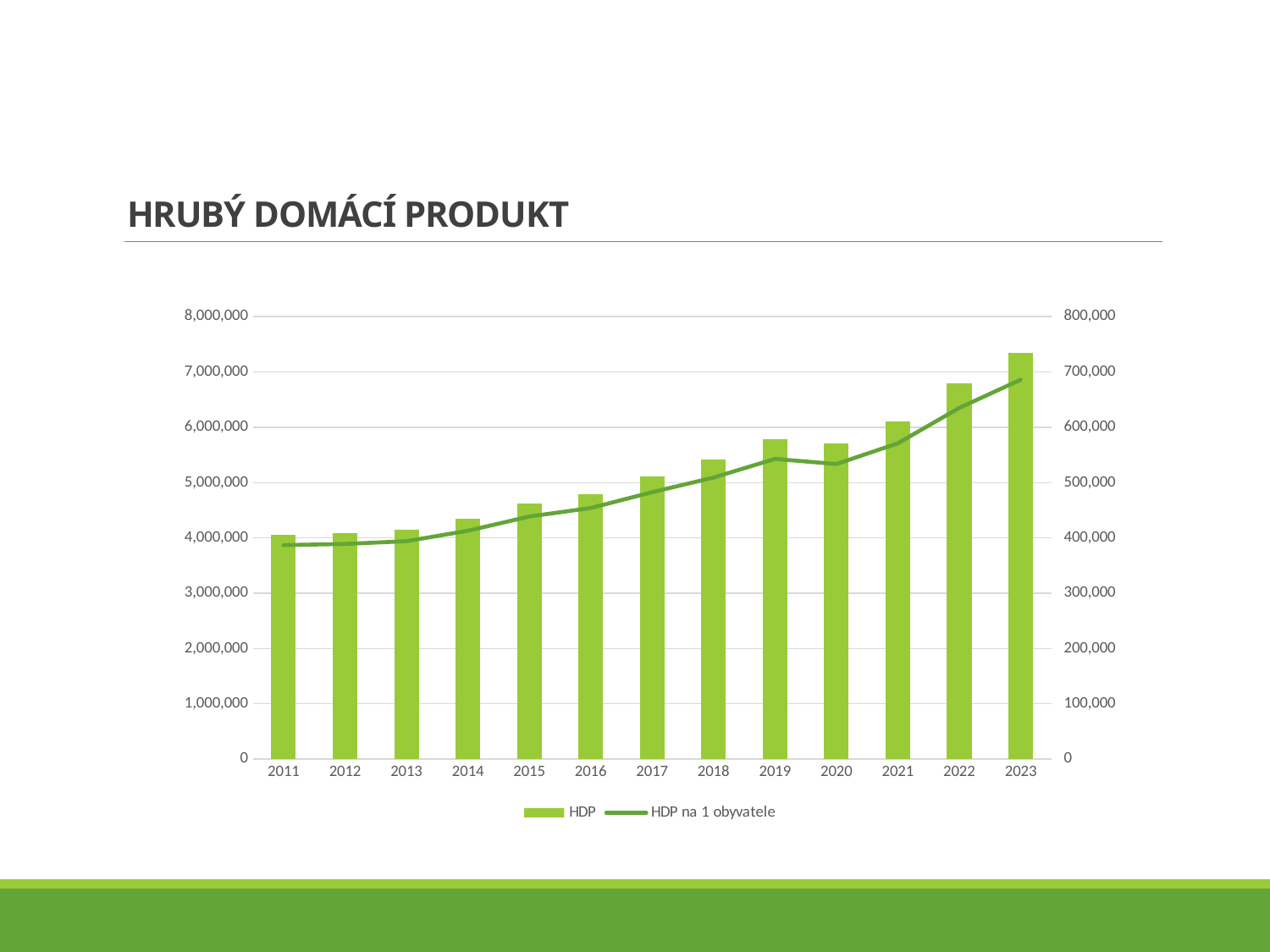
Is the HDP value for 2011 greater or less than 5,000,000? less What kind of chart is shown on the slide? A combined bar and line chart Is the HDP value for 2023 greater or less than 7,000,000? greater Is the HDP na 1 obyvatele value for 2023 greater or less than 600,000? greater Which series is drawn as a line? HDP na 1 obyvatele Which year has the highest HDP bar? 2023 Which year has the larger HDP bar, 2020 or 2021? 2021 Do the HDP values generally rise or fall from 2011 to 2023? rise How many years are shown on the x axis? 13 What is the title of the chart? HRUBÝ DOMÁCÍ PRODUKT How many series does the legend list? 2